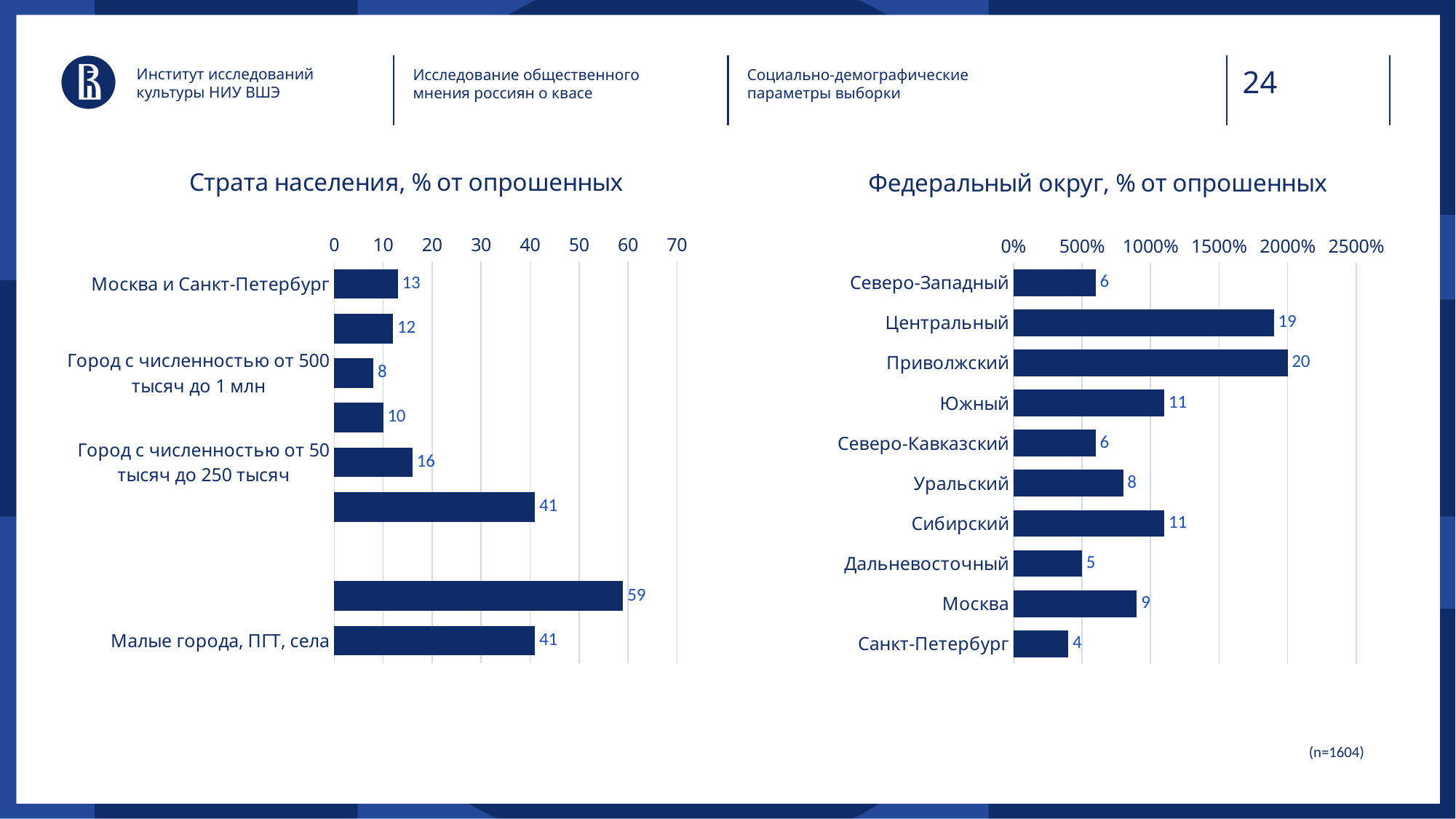
In the chart 'Страта населения, % от опрошенных', which category has the lowest value? Город с численностью от 500 тысяч до 1 млн In the chart 'Страта населения, % от опрошенных', what is the value for 'Москва и Санкт-Петербург'? 13 In the chart 'Федеральный округ, % от опрошенных', how many categories are shown? 10 What type of chart is 'Федеральный округ, % от опрошенных'? Bar chart In the chart 'Федеральный округ, % от опрошенных', which federal district has the highest value? Приволжский In the chart 'Страта населения, % от опрошенных', how many bars are plotted? 8 In the chart 'Страта населения, % от опрошенных', what is the difference between 'Малые города, ПГТ, села' and 'Москва и Санкт-Петербург'? 28 In the chart 'Федеральный округ, % от опрошенных', which category has the lowest value? Санкт-Петербург In the chart 'Страта населения, % от опрошенных', what is the value for 'Город с численностью от 50 тысяч до 250 тысяч'? 16 In the chart 'Страта населения, % от опрошенных', what is the value for 'Малые города, ПГТ, села'? 41 In the chart 'Федеральный округ, % от опрошенных', what is the value for 'Центральный'? 19 In the chart 'Федеральный округ, % от опрошенных', which is larger: 'Москва' or 'Уральский'? Москва